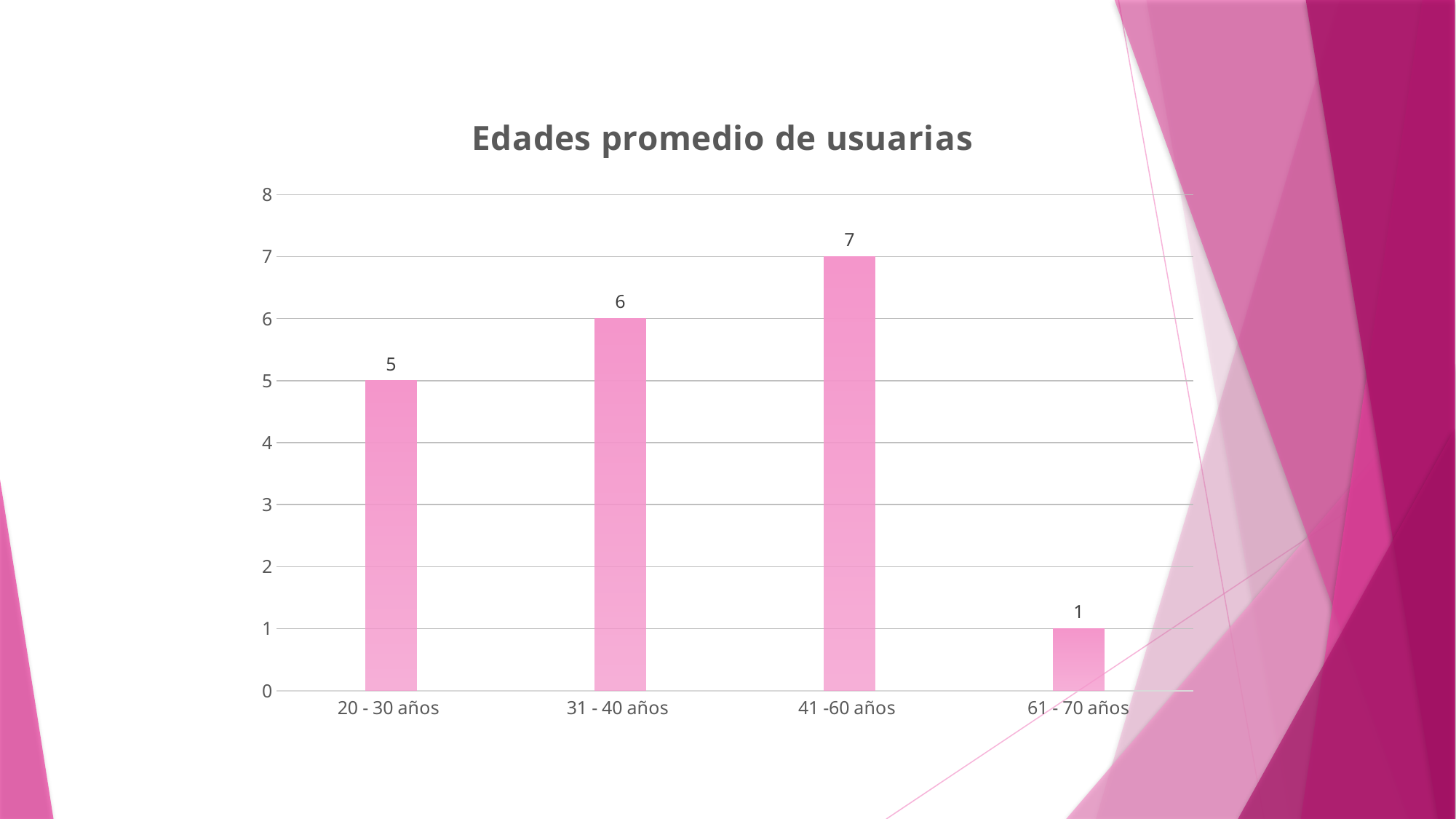
What is the value for 61 - 70 años? 1 What is the value for 41 -60 años? 7 What is the value for 31 - 40 años? 6 Is the value for 41 -60 años greater or less than 4? greater What is the difference between the values for 41 -60 años and 61 - 70 años? 6 What is the value for 20 - 30 años? 5 What kind of chart is shown on the slide? Bar chart What is the title of the chart? Edades promedio de usuarias How many age groups are shown on the chart? 4 Which age group has the lowest value? 61 - 70 años Which is larger, the value for 20 - 30 años or the value for 31 - 40 años? 31 - 40 años Which age group has the highest value? 41 -60 años